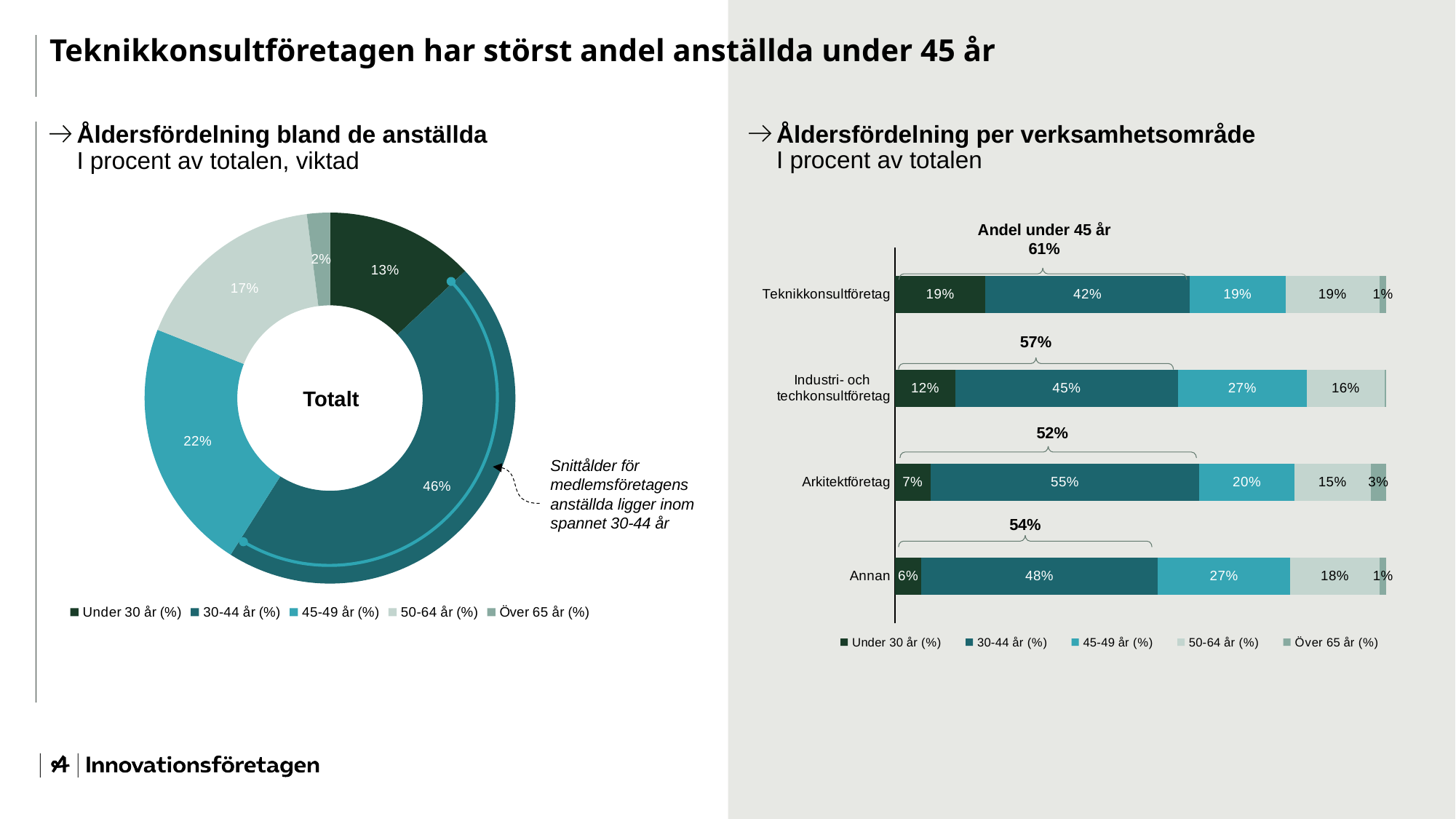
How many categories are shown in the chart 'Åldersfördelning per verksamhetsområde'? 4 In the chart 'Åldersfördelning per verksamhetsområde', what is the difference between the 45-49 år values for Industri- och techkonsultföretag and Teknikkonsultföretag? 8% How many series does the legend of the chart 'Åldersfördelning per verksamhetsområde' list? 5 In the chart 'Åldersfördelning per verksamhetsområde', what is the 'Andel under 45 år' for Teknikkonsultföretag? 61% What kind of chart is 'Åldersfördelning bland de anställda'? Donut (pie) chart In the chart 'Åldersfördelning bland de anställda', what is the difference between the 45-49 år share and the 50-64 år share? 5% In the chart 'Åldersfördelning bland de anställda', which age group has the largest share? 30-44 år (%) In the chart 'Åldersfördelning per verksamhetsområde', which is larger: the Under 30 år value for Industri- och techkonsultföretag or for Annan? Industri- och techkonsultföretag In the chart 'Åldersfördelning per verksamhetsområde', which category has the lowest 'Andel under 45 år'? Arkitektföretag In the chart 'Åldersfördelning bland de anställda', what share of employees are in the 30-44 år group? 46% In the chart 'Åldersfördelning per verksamhetsområde', what is the 30-44 år value for Arkitektföretag? 55% In the chart 'Åldersfördelning bland de anställda', which age group has the smallest share? Över 65 år (%)